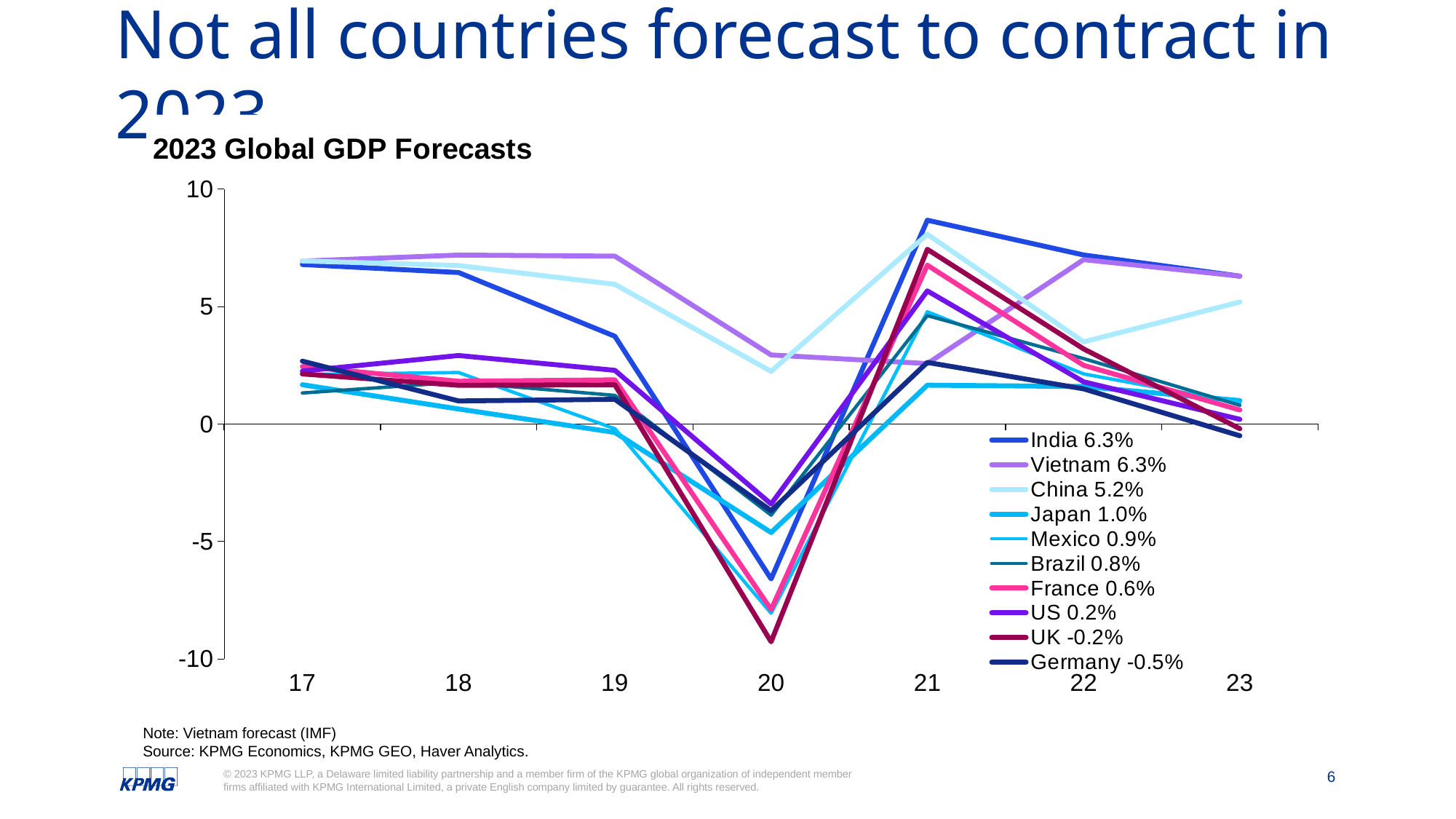
What is the 2023 GDP forecast for the UK shown in the legend? -0.2% How many years are shown along the x axis? 7 Which country has the lowest 2023 GDP forecast in the legend? Germany How many series does the legend list? 10 What is the difference between the 2023 forecasts for India and China? 1.1% What kind of chart is shown on the slide? line chart What is the 2023 GDP forecast for China shown in the legend? 5.2% What is the title of the chart? 2023 Global GDP Forecasts Is the value for India in 2020 greater or less than -5? less What is the 2023 GDP forecast for Germany shown in the legend? -0.5% Which has the larger 2023 forecast, Japan or Mexico? Japan Is the value for China in 2020 greater or less than 0? greater